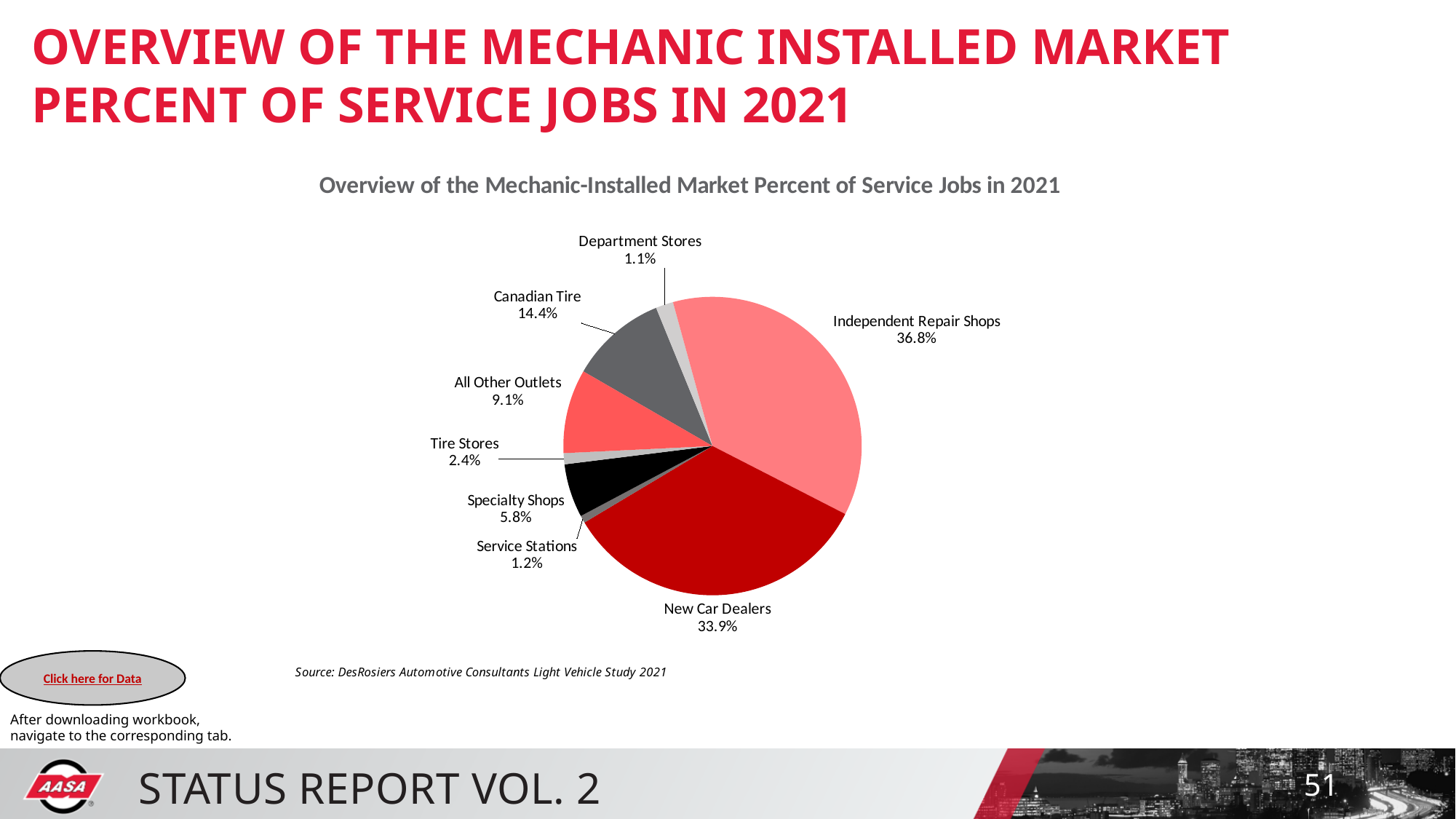
How many categories are shown in the pie chart? 8 Which category has the largest share of service jobs? Independent Repair Shops Which has a larger share, All Other Outlets or Specialty Shops? All Other Outlets Which category has the smallest share of service jobs? Department Stores What is the difference in percentage points between Independent Repair Shops and New Car Dealers? 2.9 What is the source cited below the chart? DesRosiers Automotive Consultants Light Vehicle Study 2021 What percentage is shown for Specialty Shops? 5.8% Which has a larger share, Tire Stores or Service Stations? Tire Stores What percent of service jobs do Independent Repair Shops account for? 36.8% What is the share shown for Canadian Tire? 14.4% What kind of chart is shown on the slide? Pie chart What is the difference in percentage points between Canadian Tire and All Other Outlets? 5.3